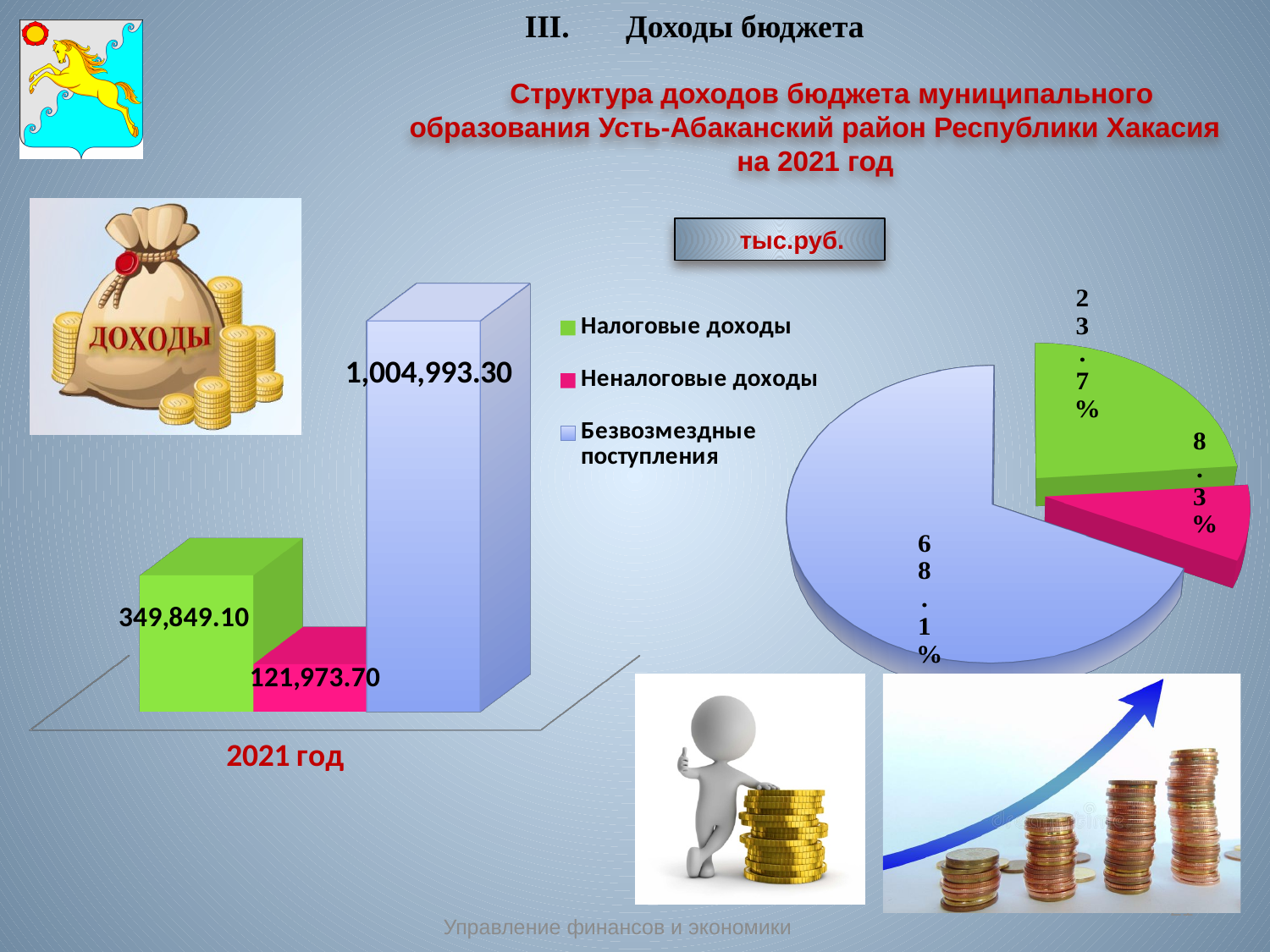
On the bar chart, what is the difference between Налоговые доходы and Неналоговые доходы? 227,875.40 On the bar chart, which is larger: Налоговые доходы or Неналоговые доходы? Налоговые доходы On the bar chart, which series has the highest value? Безвозмездные поступления On the bar chart, what is the value for Неналоговые доходы? 121,973.70 On the bar chart, which series has the lowest value? Неналоговые доходы On the pie chart, what share does the green slice (Налоговые доходы) have? 23.7% How many series does the legend of the bar chart list? 3 On the pie chart, what share does the pink slice (Неналоговые доходы) have? 8.3% On the bar chart, what is the value for Безвозмездные поступления? 1,004,993.30 What kind of chart is the chart on the left side of the slide? bar chart On the bar chart, what is the value for Налоговые доходы? 349,849.10 On the pie chart, what share does the largest slice (Безвозмездные поступления) have? 68.1%